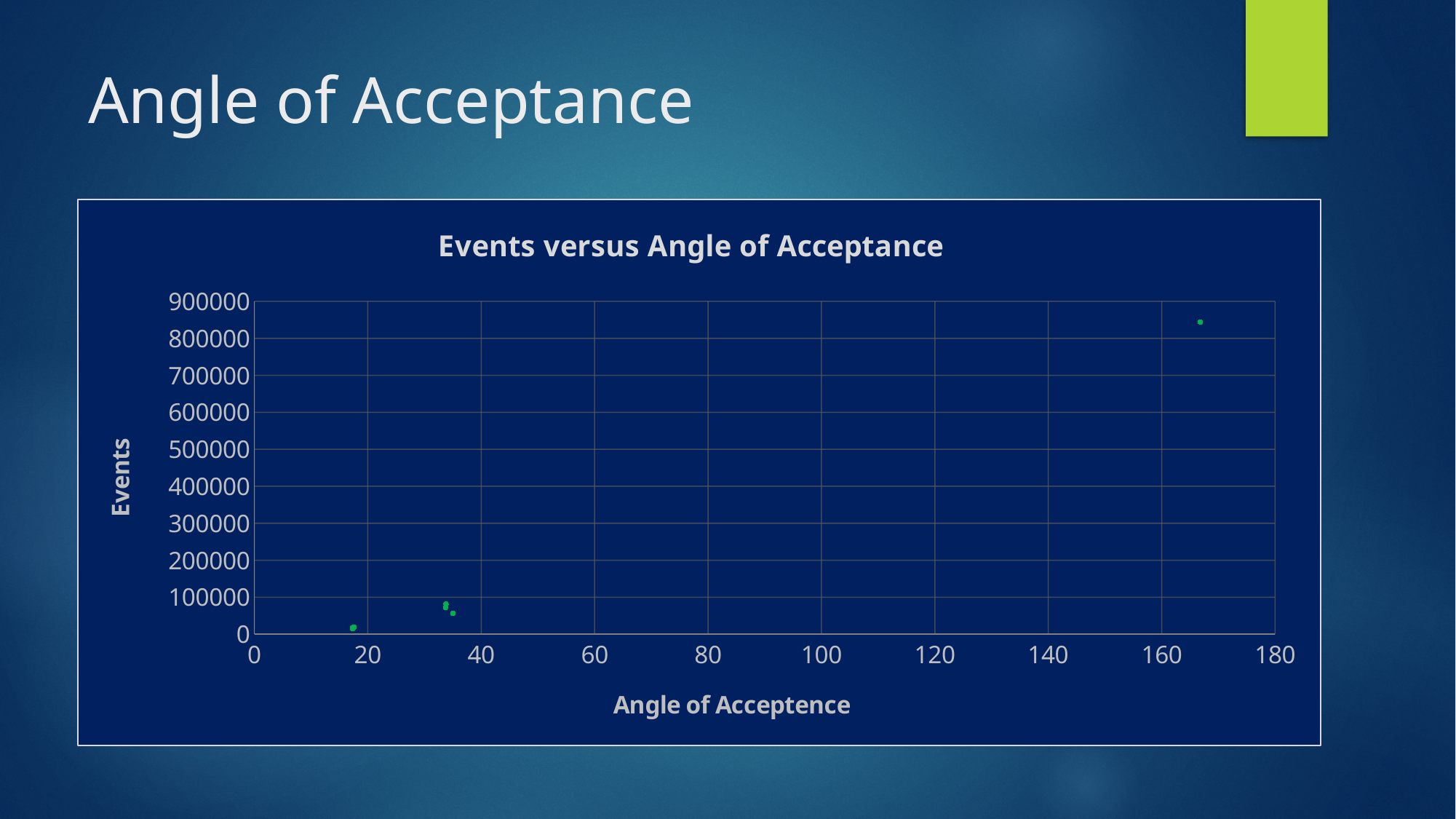
Which has the larger Events value: the point near an angle of 167 or the point near an angle of 17? The point near an angle of 167 Do the Events values rise or fall as the Angle of Acceptance increases? rise Is the point with the highest Events value located at an angle greater or less than 160? greater What is the label on the horizontal axis of the chart? Angle of Acceptence Is the point with the lowest Events value located at an angle greater or less than 20? less What is the maximum value shown on the vertical (Events) axis? 900000 What is the title of the chart? Events versus Angle of Acceptance Is the Events value for the point plotted near an angle of 167 greater or less than 800000? greater Are the Events values for the points plotted between angles of 30 and 40 greater or less than 200000? less What kind of chart is shown on the slide? Scatter chart Is the Events value for the point plotted near an angle of 17 greater or less than 100000? less